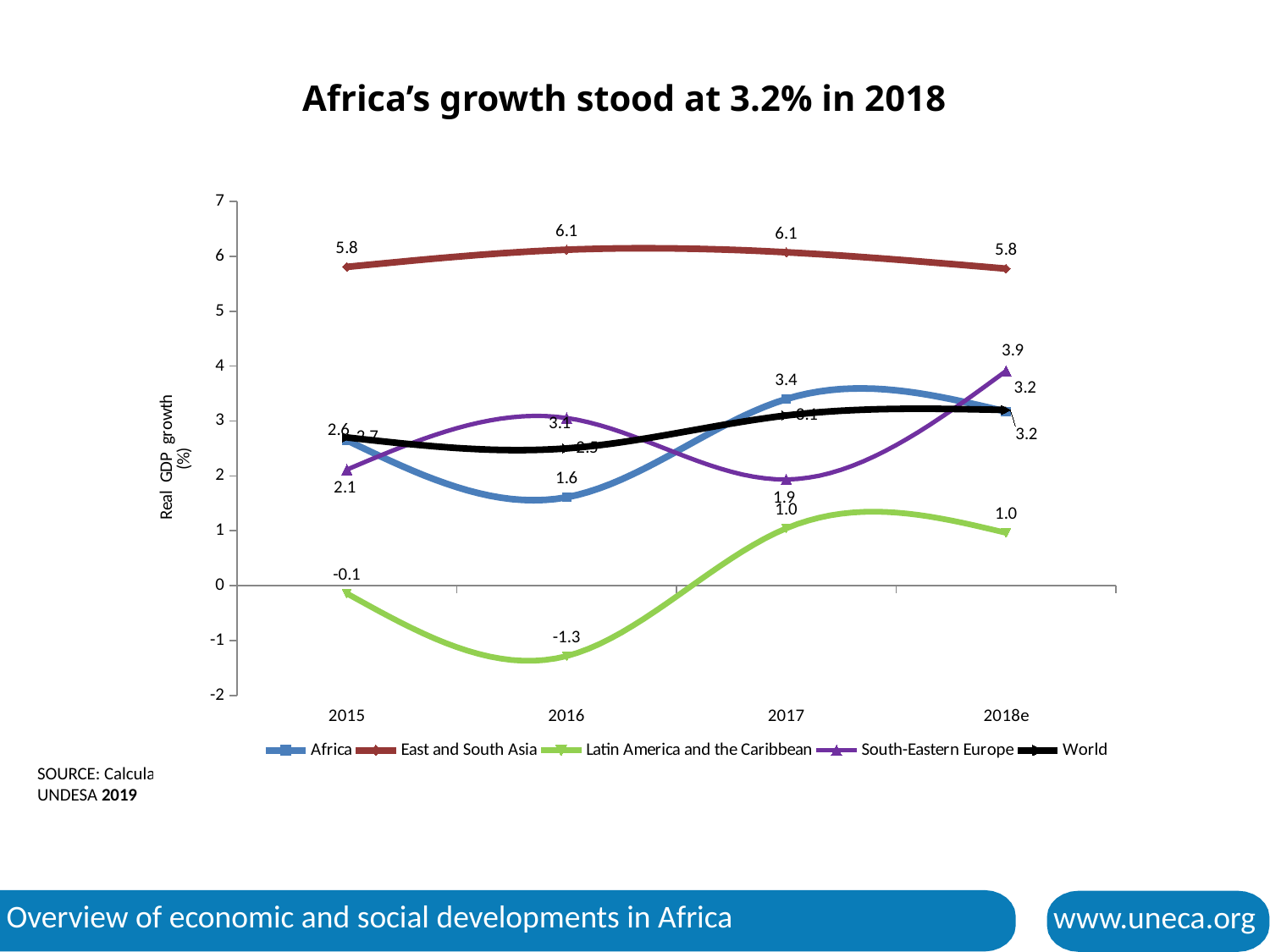
What was the value for South-Eastern Europe in 2018e? 3.9 What kind of chart is shown on the slide? Line chart By how much did East and South Asia's growth rise from 2015 to 2016? 0.3 Which region had the lowest real GDP growth in 2016? Latin America and the Caribbean What was Africa's real GDP growth in 2016? 1.6 How many years are shown on the x axis? 4 Which region had the highest real GDP growth in 2018e? East and South Asia What was the value for Latin America and the Caribbean in 2016? -1.3 In 2017, which had higher growth: Africa or South-Eastern Europe? Africa How many series does the legend list? 5 What was the real GDP growth for East and South Asia in 2016? 6.1 What was Africa's real GDP growth in 2017? 3.4